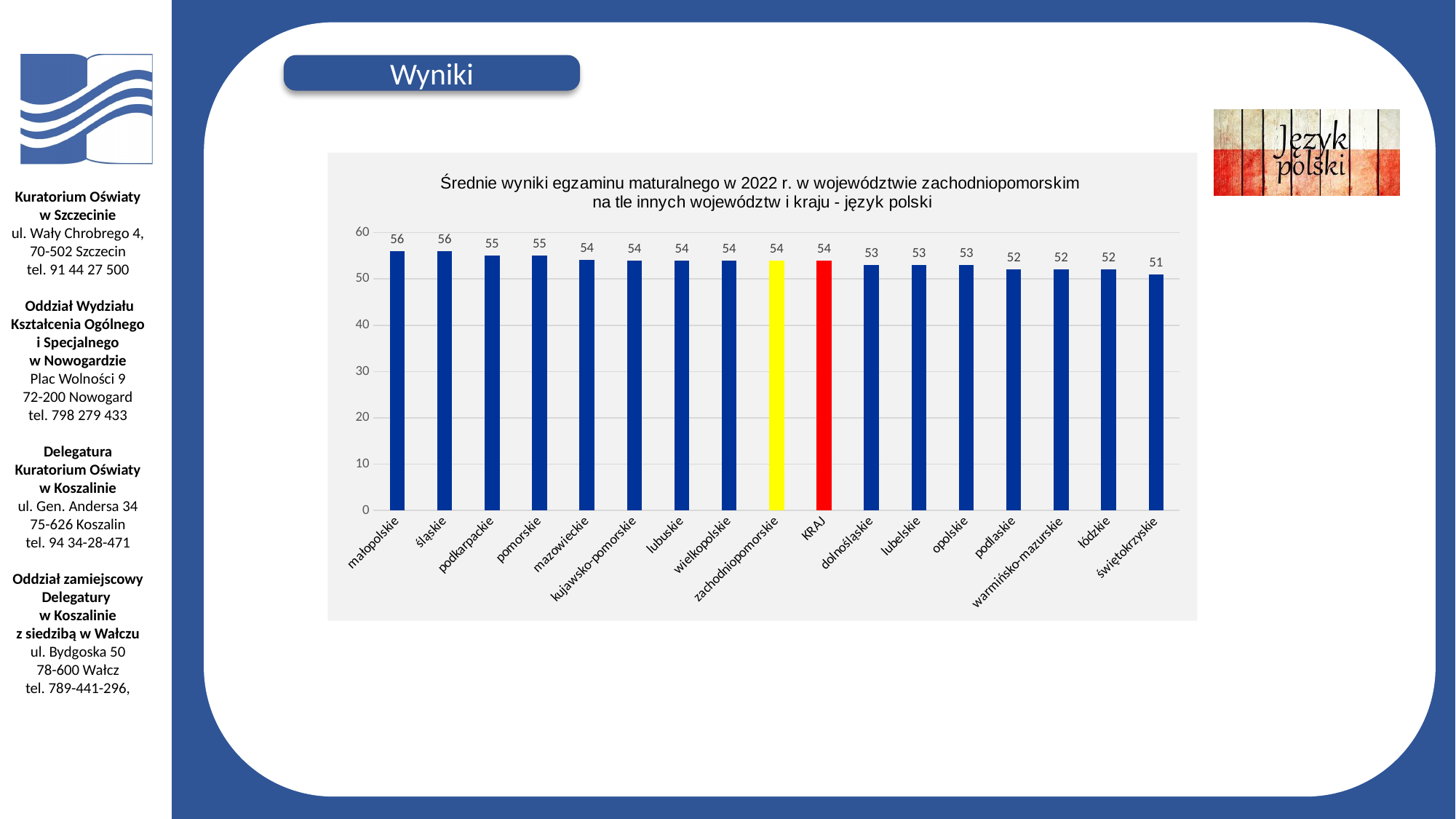
Do the values rise or fall from left to right along the x axis? fall What is the difference between the values for małopolskie and świętokrzyskie? 5 What is the value for zachodniopomorskie in the chart? 54 How many bars are shown in the chart? 17 What is the value for KRAJ in the chart? 54 What kind of chart is shown on the slide? bar chart What is the value for dolnośląskie in the chart? 53 Which has a larger value, podkarpackie or łódzkie? podkarpackie What is the value for świętokrzyskie in the chart? 51 Which category has the lowest value in the chart? świętokrzyskie Is the value for lubelskie greater or less than 50? greater What colour is the bar for zachodniopomorskie? yellow